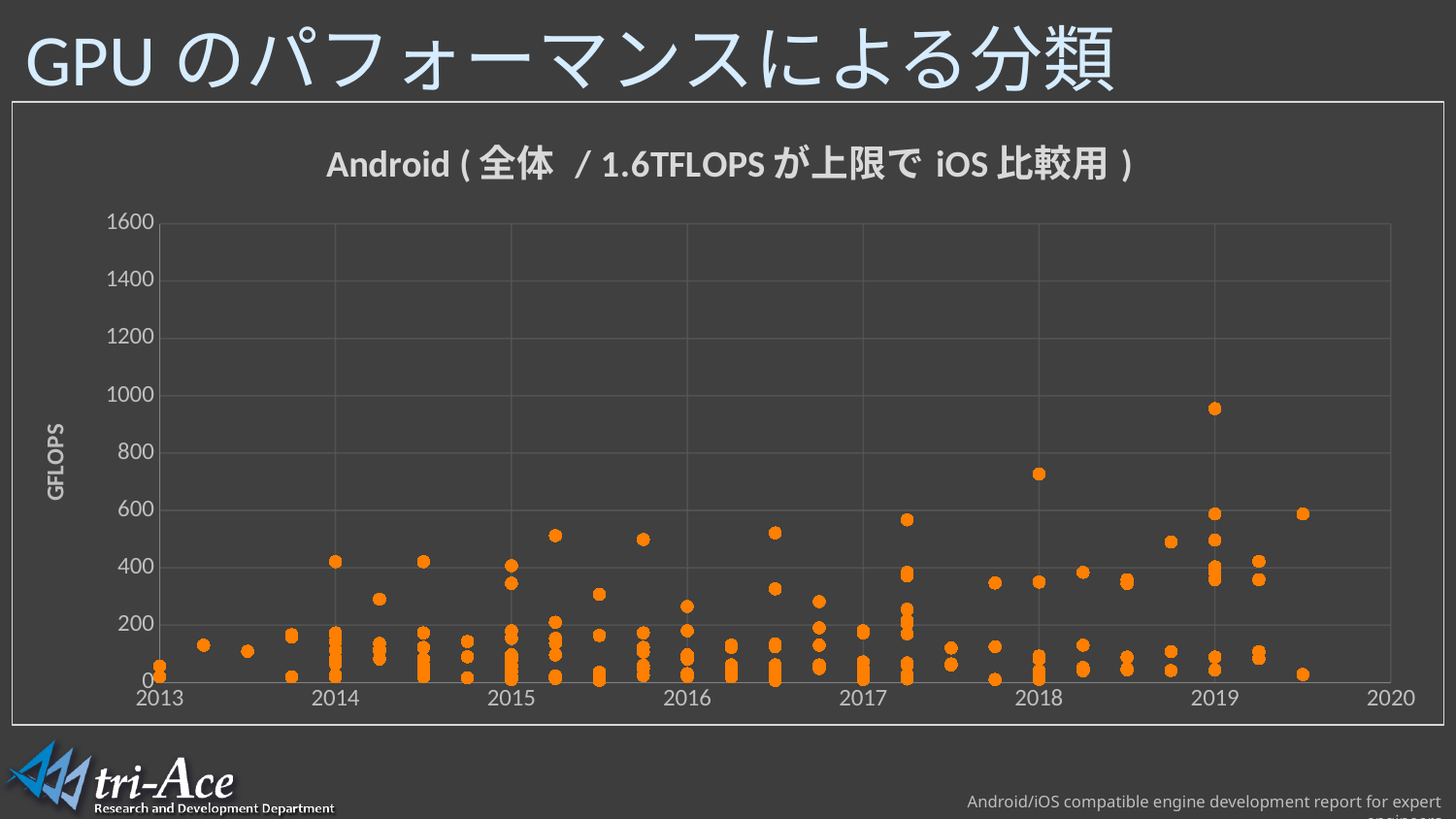
Which year has a higher maximum plotted value, 2018 or 2019? 2019 Is the highest plotted point in 2019 greater or less than 800 GFLOPS? greater In which year does the highest plotted point appear? 2019 Which year has a higher maximum plotted value, 2013 or 2014? 2014 Do the maximum plotted values generally rise or fall from 2013 to 2019? rise What kind of chart is shown on the slide? scatter chart Is the highest plotted point in 2019 greater or less than 1000 GFLOPS? less Is the highest plotted point in 2013 greater or less than 200 GFLOPS? less How many year labels are shown on the horizontal axis? 8 What is the label on the vertical axis of the chart? GFLOPS What is the title of the chart? Android ( 全体 / 1.6TFLOPS が上限で iOS 比較用 )